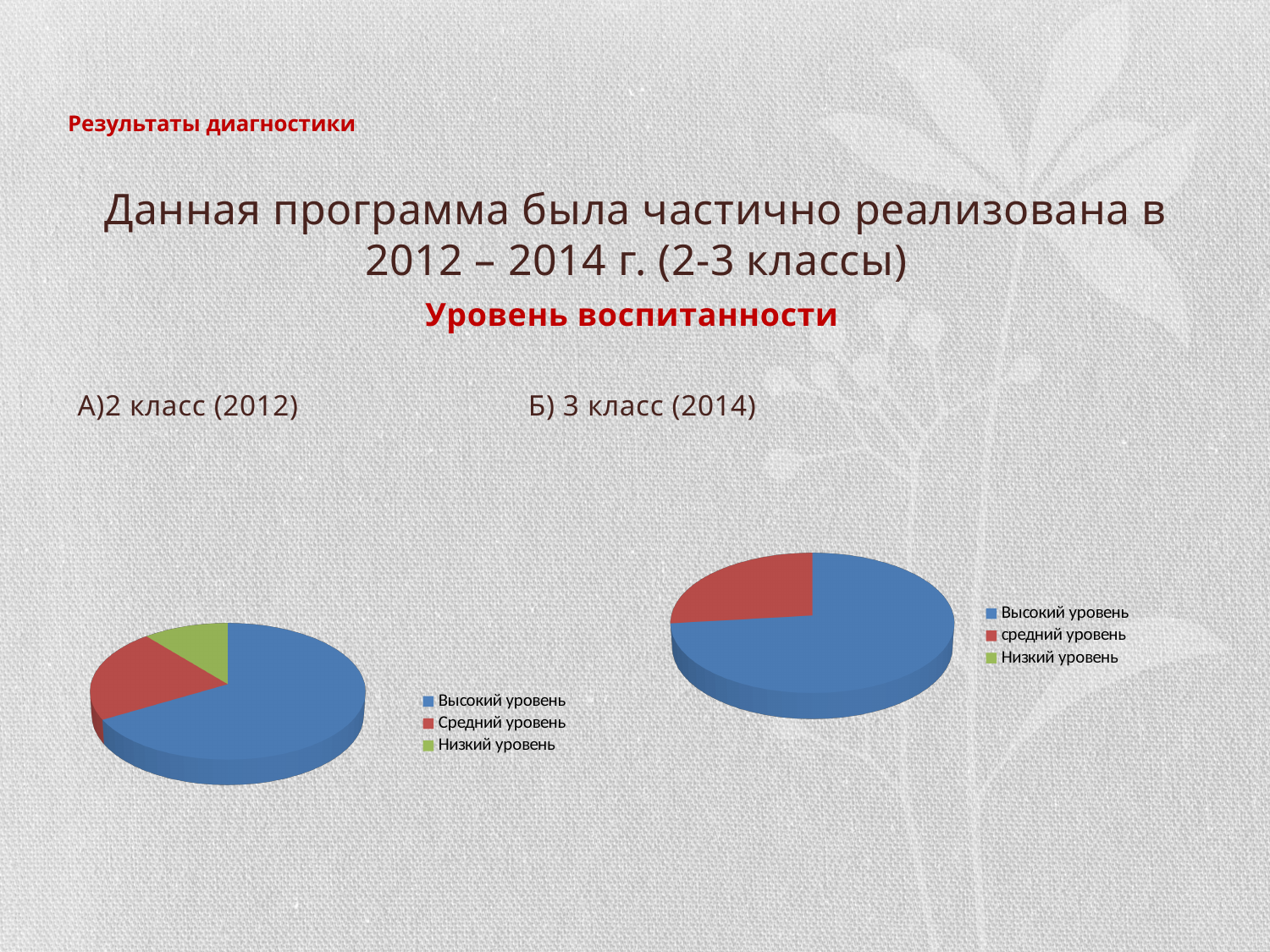
How many slices are visible in the left chart (А)2 класс (2012))? 3 What kind of chart is shown under "Б) 3 класс (2014)"? pie chart What kind of chart is shown under "А)2 класс (2012)"? pie chart In the right chart (Б) 3 класс (2014)), which category has the largest slice? Высокий уровень In the left chart (А)2 класс (2012)), which is larger: Средний уровень or Низкий уровень? Средний уровень In the right chart (Б) 3 класс (2014)), which is larger: Высокий уровень or средний уровень? Высокий уровень How many entries does the legend of the right chart (Б) 3 класс (2014)) list? 3 In the left chart (А)2 класс (2012)), what colour represents Низкий уровень? green In the left chart (А)2 класс (2012)), which category has the smallest slice? Низкий уровень In the left chart (А)2 класс (2012)), which category has the largest slice? Высокий уровень How many entries does the legend of the left chart (А)2 класс (2012)) list? 3 How many slices are visible in the right chart (Б) 3 класс (2014))? 2